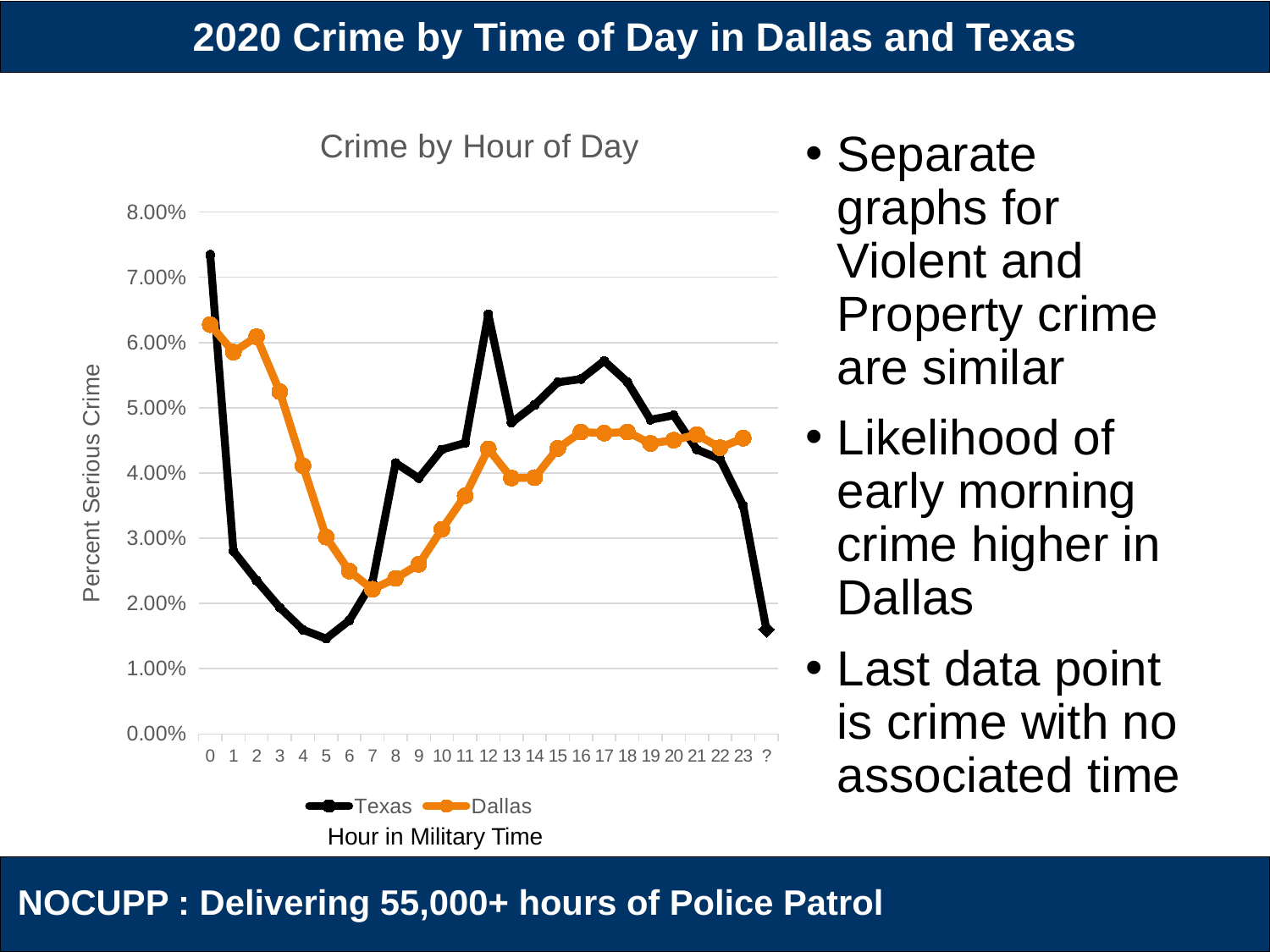
At which hour does the Texas series reach its lowest value? 5 What kind of chart is shown on the slide? Line chart At which hour does the Dallas series reach its lowest value? 7 Is the Dallas value at hour 7 greater or less than 3.00%? less Which two series are shown in the legend of the Crime by Hour of Day chart? Texas and Dallas Is the Texas value at hour 0 greater or less than 7.00%? greater Is the Texas value at the '?' category greater or less than 2.00%? less At hour 2, which series has the higher value, Texas or Dallas? Dallas At which hour does the Texas series reach its highest value? 0 How many series does the legend list in the Crime by Hour of Day chart? 2 How many points are plotted along the x axis for each series (hours 0 through 23 plus '?')? Texas: 25; Dallas: 24 (Dallas has no point at '?') Does the Texas series rise or fall from hour 0 to hour 5? Fall